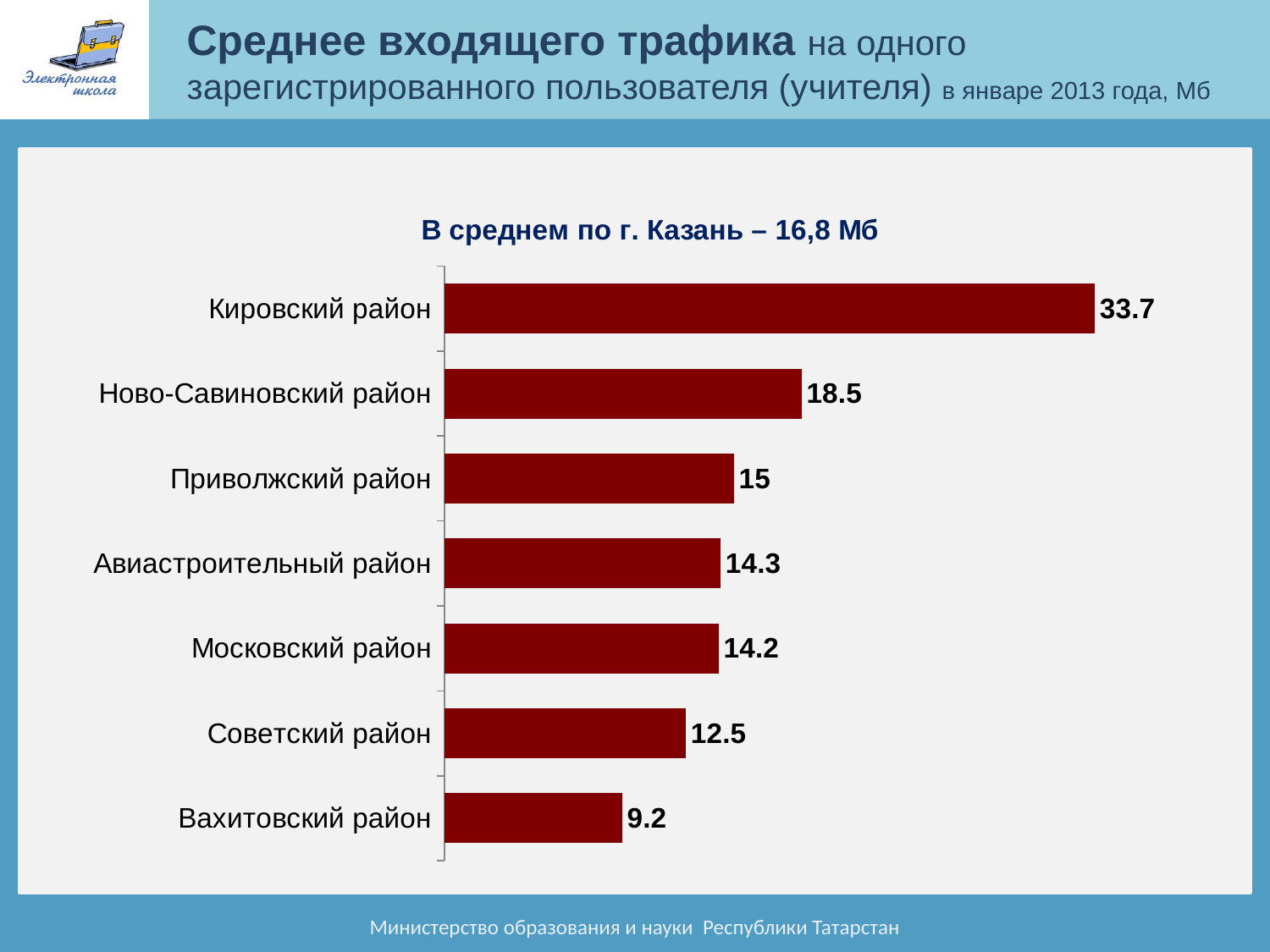
How many districts are shown in the chart? 7 What colour are the bars in the chart? dark red Which is larger, the value for Ново-Савиновский район or Приволжский район? Ново-Савиновский район What is the difference between the values for Кировский район and Ново-Савиновский район? 15.2 Which district has the lowest value? Вахитовский район What is the difference between the values for Советский район and Вахитовский район? 3.3 Which district has the highest value? Кировский район What is the value for Кировский район? 33.7 What is the value for Советский район? 12.5 What is the value for Приволжский район? 15 What kind of chart is shown on the slide? bar chart What is the average value for Kazan stated above the chart? 16,8 Мб